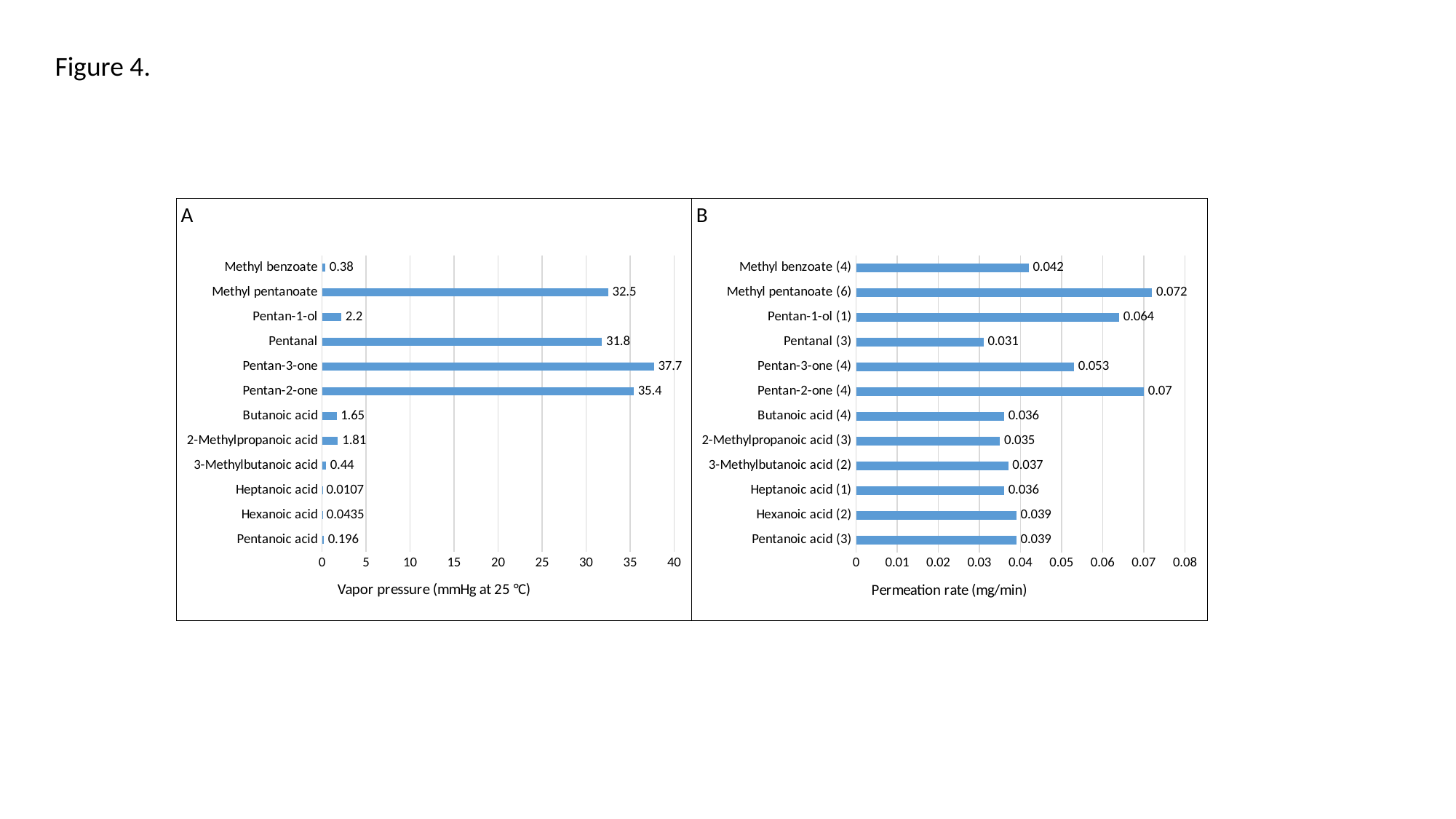
In chart B (Permeation rate), which compound has the lowest permeation rate? Pentanal (3) What type of chart is chart B (Permeation rate)? Bar chart In chart A (Vapor pressure), what is the vapor pressure of Heptanoic acid? 0.0107 In chart A (Vapor pressure), what is the vapor pressure of Pentan-3-one? 37.7 What is the x-axis title of chart A? Vapor pressure (mmHg at 25 °C) In chart A (Vapor pressure), which compound has the highest vapor pressure? Pentan-3-one In chart A (Vapor pressure), how many compounds are plotted? 12 In chart B (Permeation rate), what is the difference in permeation rate between Pentan-1-ol (1) and Methyl benzoate (4)? 0.022 In chart A (Vapor pressure), which compound has the lowest vapor pressure? Heptanoic acid In chart B (Permeation rate), what is the permeation rate of Methyl pentanoate (6)? 0.072 In chart A (Vapor pressure), which has the higher vapor pressure, Butanoic acid or 2-Methylpropanoic acid? 2-Methylpropanoic acid In chart A (Vapor pressure), what is the difference in vapor pressure between Pentan-2-one and Pentanal? 3.6